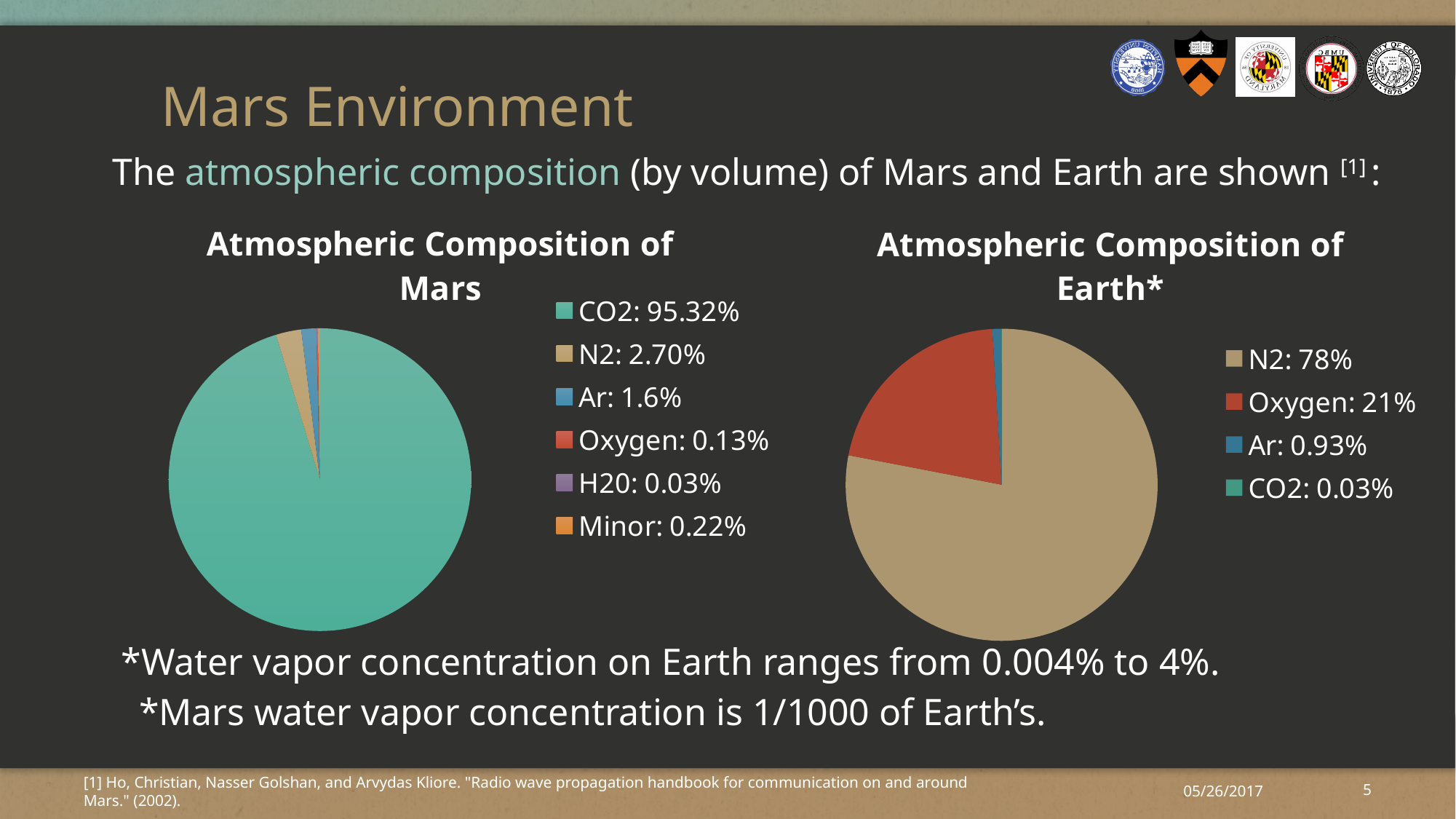
How many components does the legend of the 'Atmospheric Composition of Earth*' chart list? 4 What type of chart is the 'Atmospheric Composition of Earth*' chart? Pie chart In the 'Atmospheric Composition of Mars' chart, which is larger, N2 or Ar? N2 In the 'Atmospheric Composition of Earth*' chart, which component has the smallest share? CO2 In the 'Atmospheric Composition of Mars' chart, which component has the largest share? CO2 In the 'Atmospheric Composition of Earth*' chart, what percentage is Oxygen? 21% In the 'Atmospheric Composition of Mars' chart, which component has the smallest share? H20 In the 'Atmospheric Composition of Mars' chart, what percentage is N2? 2.70% In the 'Atmospheric Composition of Mars' chart, what percentage is CO2? 95.32% How many components does the legend of the 'Atmospheric Composition of Mars' chart list? 6 In the 'Atmospheric Composition of Earth*' chart, what percentage is Ar? 0.93% In the 'Atmospheric Composition of Earth*' chart, what is the difference between the N2 and Oxygen percentages? 57%